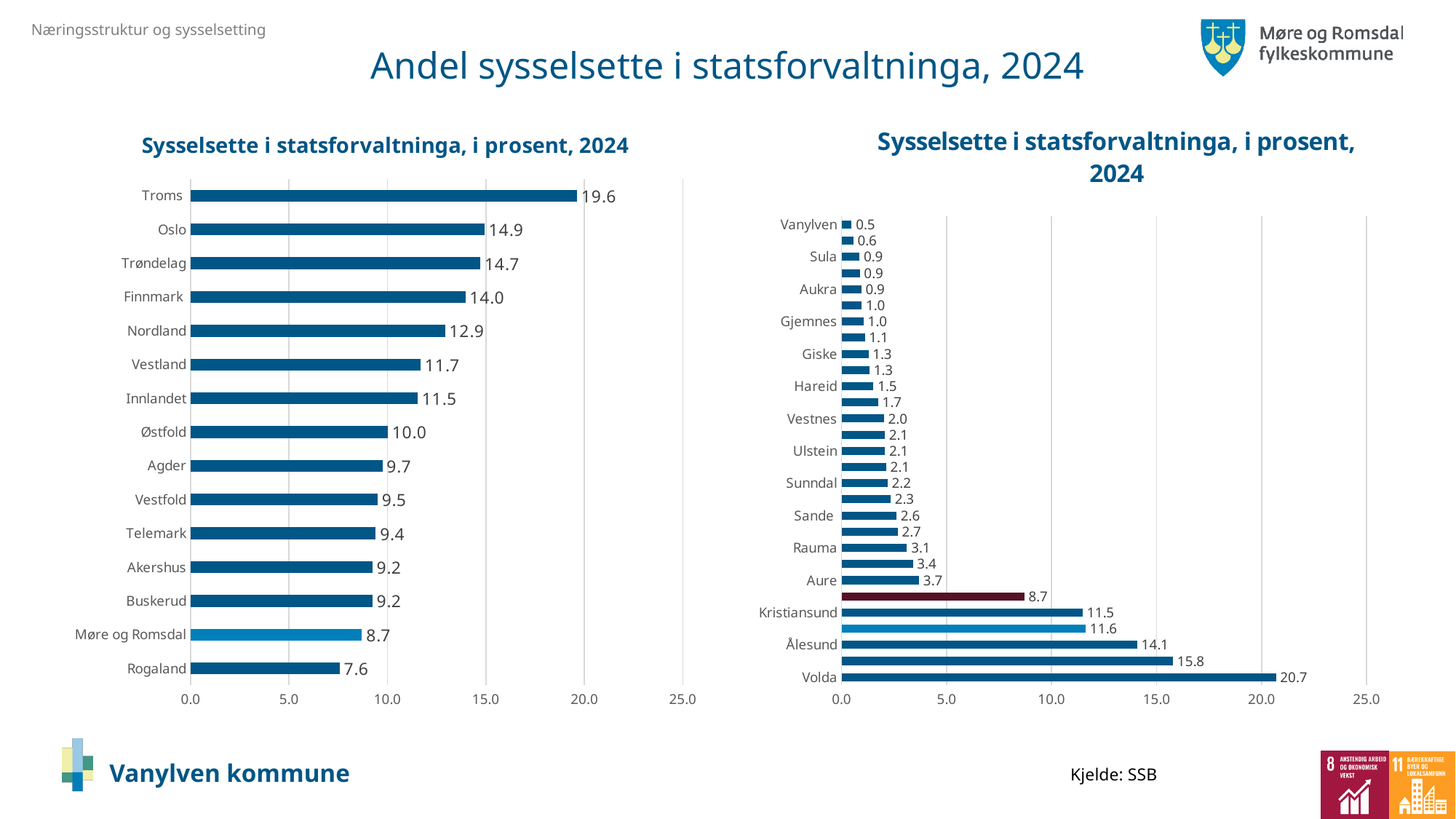
In the left chart, what is the value for Møre og Romsdal? 8.7 In the right chart, what is the value for Volda? 20.7 In the right chart, which is larger, the value for Kristiansund or the value for Ålesund? Ålesund How many categories are shown in the left chart? 15 What kind of chart is the left chart? bar chart In the left chart, which category has the highest value? Troms In the left chart, which category's bar is drawn in a lighter colour than the others? Møre og Romsdal In the right chart, what is the value for Vanylven? 0.5 In the right chart, which category has the highest value? Volda In the left chart, what is the difference between the values for Troms and Rogaland? 12.0 In the left chart, which category has the lowest value? Rogaland In the left chart, what is the value for Troms? 19.6